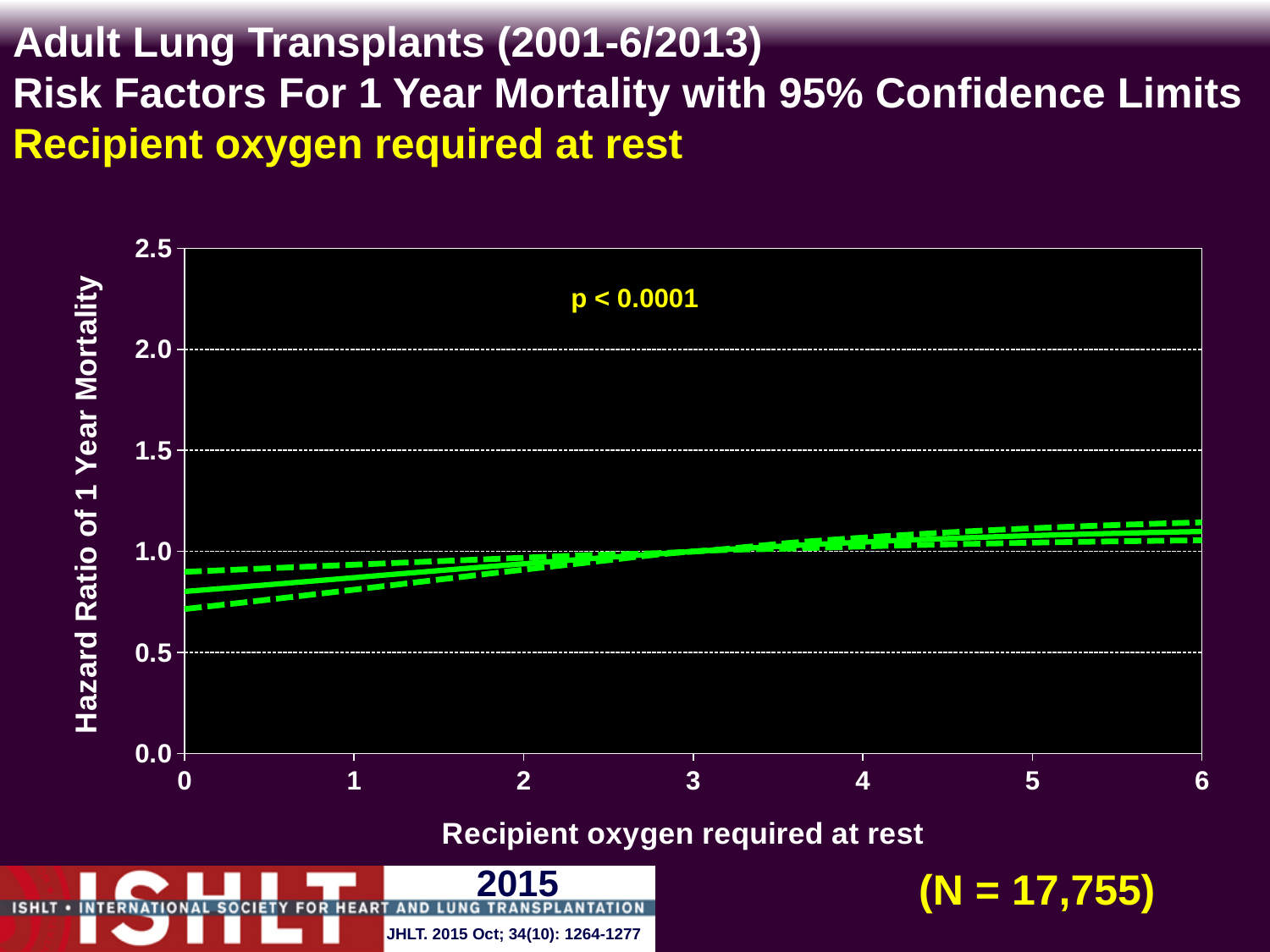
How many lines (solid and dashed) are plotted on the chart? 3 What kind of chart is shown on the slide? line chart Is the hazard ratio (solid line) at a recipient oxygen value of 6 greater or less than 1.5? less Is the upper confidence limit at a recipient oxygen value of 0 greater or less than 1.0? less Does the hazard ratio of 1 year mortality rise or fall as recipient oxygen required at rest increases from 0 to 6? rise Is the hazard ratio (solid line) at a recipient oxygen value of 0 greater or less than 1.0? less What is the highest value shown on the y axis of the chart? 2.5 Is the hazard ratio larger at a recipient oxygen value of 0 or at a value of 6? 6 What p-value is printed on the chart? p < 0.0001